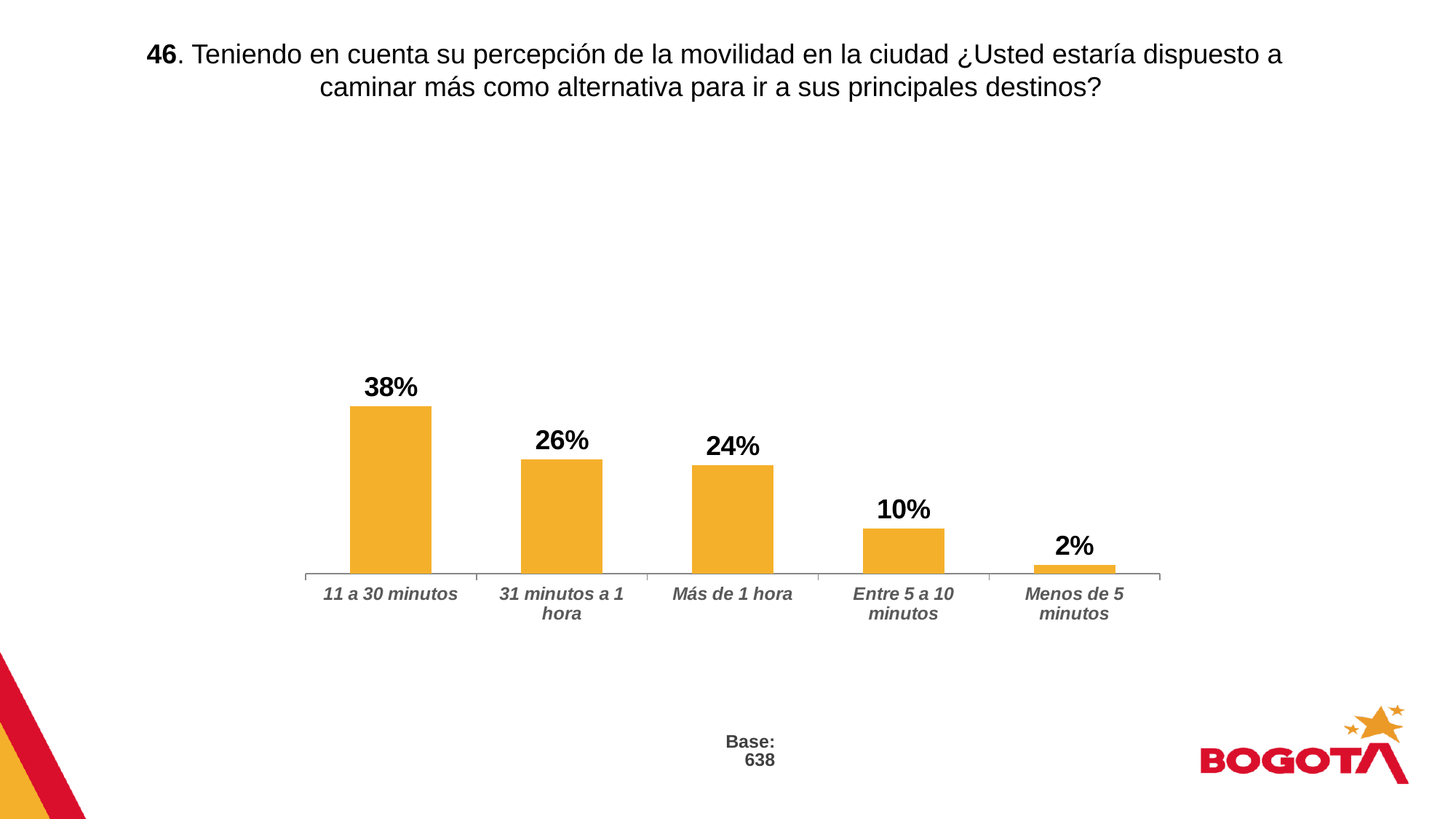
What is the difference between the values for "11 a 30 minutos" and "31 minutos a 1 hora"? 12% Which category has the highest value? 11 a 30 minutos What is the value for "Más de 1 hora"? 24% Which is larger, the value for "Más de 1 hora" or the value for "Entre 5 a 10 minutos"? Más de 1 hora How many categories are shown in the chart? 5 What is the value for "Menos de 5 minutos"? 2% What is the value for "31 minutos a 1 hora"? 26% What kind of chart is shown on the slide? Bar chart What is the value for "Entre 5 a 10 minutos"? 10% What is the value for "11 a 30 minutos"? 38% What is the base (number of respondents) shown below the chart? 638 Which category has the lowest value? Menos de 5 minutos